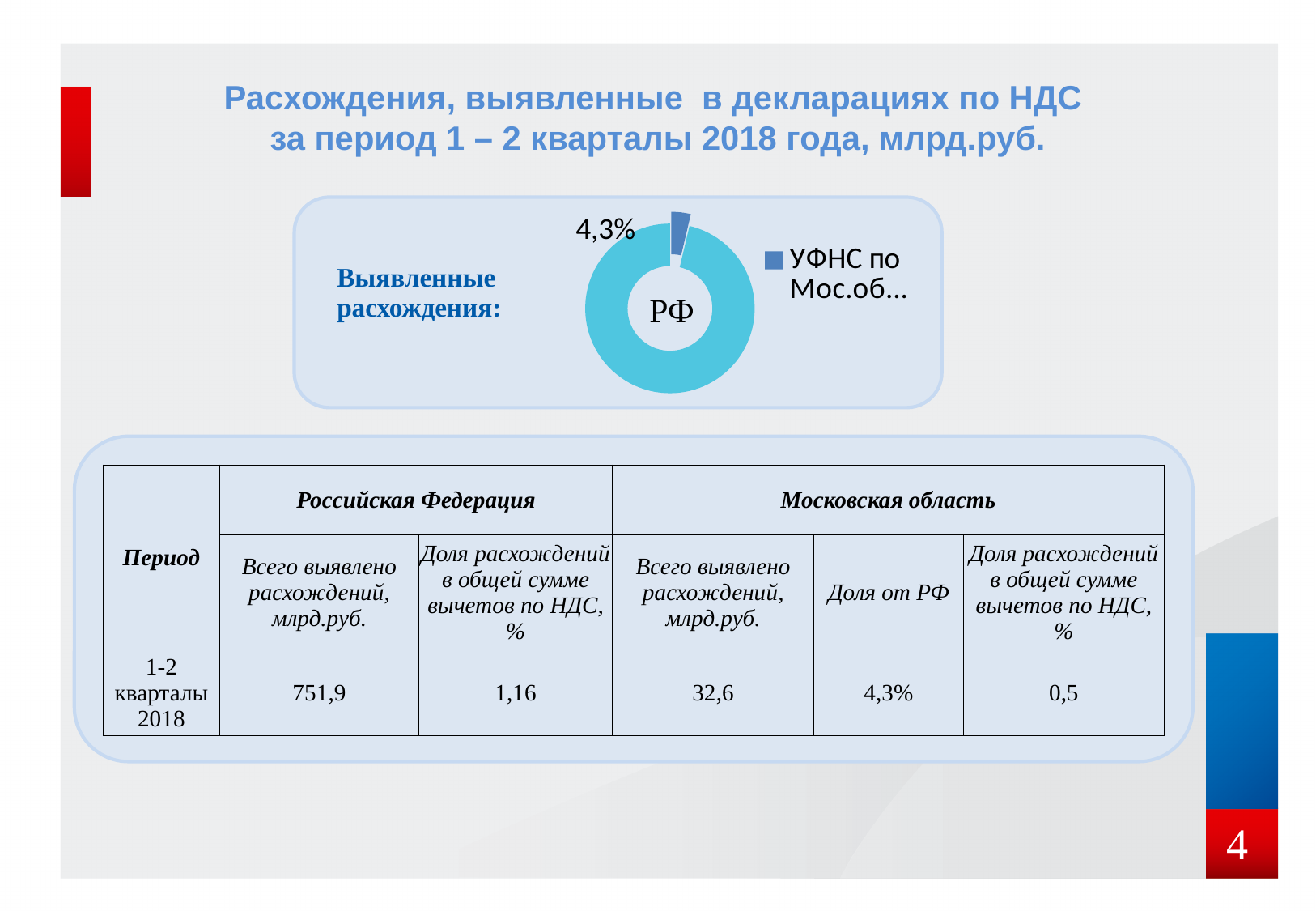
How many entries does the legend of the doughnut chart list? 1 Which slice of the doughnut chart is the largest? РФ How many slices does the doughnut chart have? 2 What kind of chart is shown on the slide? Doughnut (pie) chart What colour is the small 4,3% slice in the doughnut chart? Dark blue Is the share of the РФ slice in the doughnut chart greater or less than 50%? greater Which slice of the doughnut chart is the smallest? УФНС по Мос.об... What share of the doughnut chart is labelled for the small slice (УФНС по Мос.об...)? 4,3% Which slice of the doughnut chart is larger, РФ or УФНС по Мос.об...? РФ What label is written in the centre of the doughnut chart? РФ